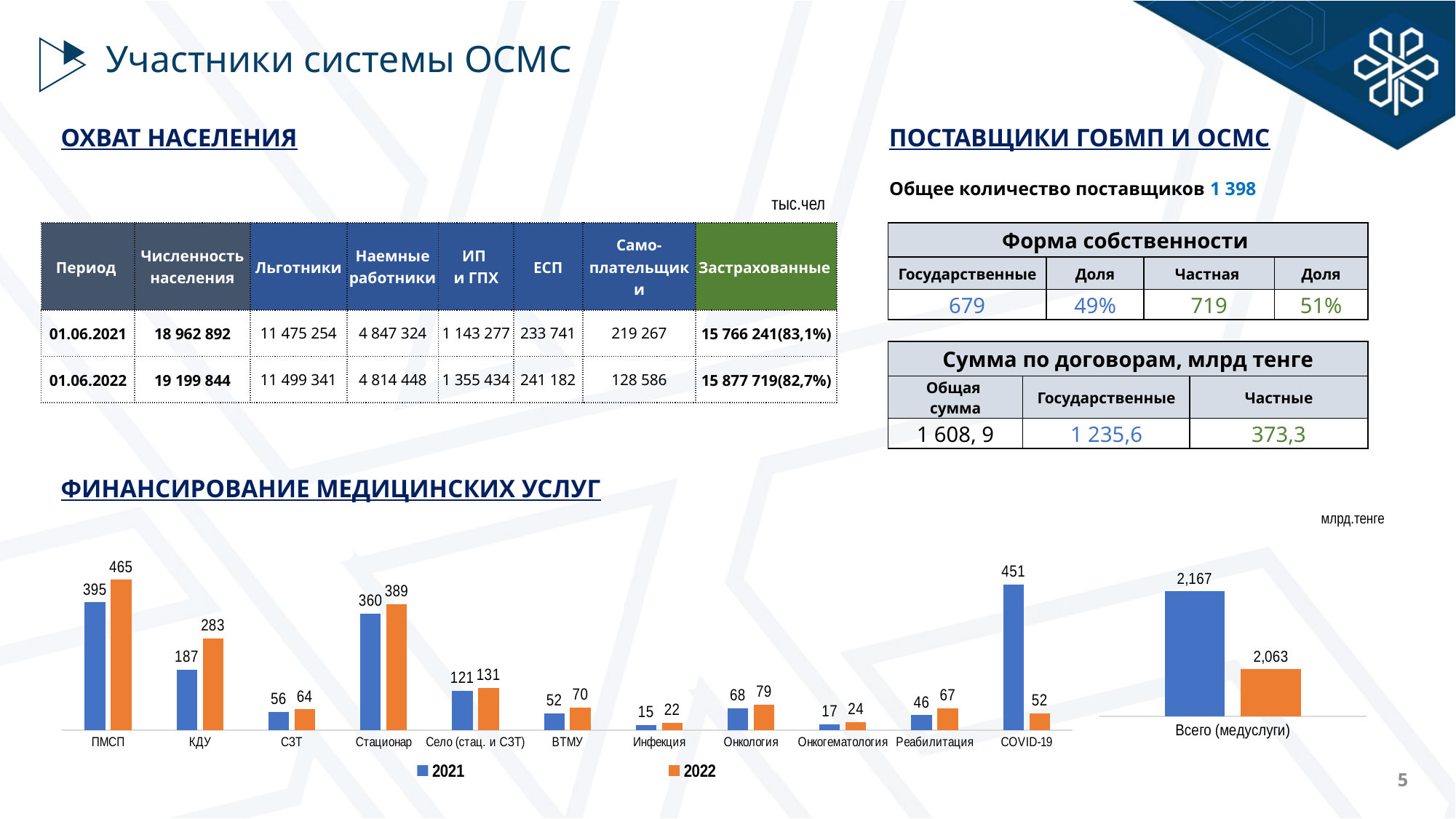
In the 'ФИНАНСИРОВАНИЕ МЕДИЦИНСКИХ УСЛУГ' chart, what unit is indicated in the top right corner of the chart? млрд.тенге In the 'ФИНАНСИРОВАНИЕ МЕДИЦИНСКИХ УСЛУГ' chart, which category (excluding Всего) has the highest 2021 value? COVID-19 In the 'ФИНАНСИРОВАНИЕ МЕДИЦИНСКИХ УСЛУГ' chart, what is the 2022 value for ПМСП? 465 In the 'ФИНАНСИРОВАНИЕ МЕДИЦИНСКИХ УСЛУГ' chart, what is the 2022 value for Реабилитация? 67 What kind of chart is shown under 'ФИНАНСИРОВАНИЕ МЕДИЦИНСКИХ УСЛУГ'? Bar chart In the 'ФИНАНСИРОВАНИЕ МЕДИЦИНСКИХ УСЛУГ' chart, what is the difference between the 2022 and 2021 values for КДУ? 96 In the 'ФИНАНСИРОВАНИЕ МЕДИЦИНСКИХ УСЛУГ' chart, which category has the lowest 2022 value? Инфекция In the 'ФИНАНСИРОВАНИЕ МЕДИЦИНСКИХ УСЛУГ' chart, what is the difference between the 2021 and 2022 values for COVID-19? 399 In the 'ФИНАНСИРОВАНИЕ МЕДИЦИНСКИХ УСЛУГ' chart, which is larger for Стационар: the 2021 value or the 2022 value? 2022 In the 'ФИНАНСИРОВАНИЕ МЕДИЦИНСКИХ УСЛУГ' chart, how many series does the legend list? 2 In the 'ФИНАНСИРОВАНИЕ МЕДИЦИНСКИХ УСЛУГ' chart, what is the 2021 value for Всего (медуслуги)? 2,167 In the 'ФИНАНСИРОВАНИЕ МЕДИЦИНСКИХ УСЛУГ' chart, what is the 2021 value for COVID-19? 451